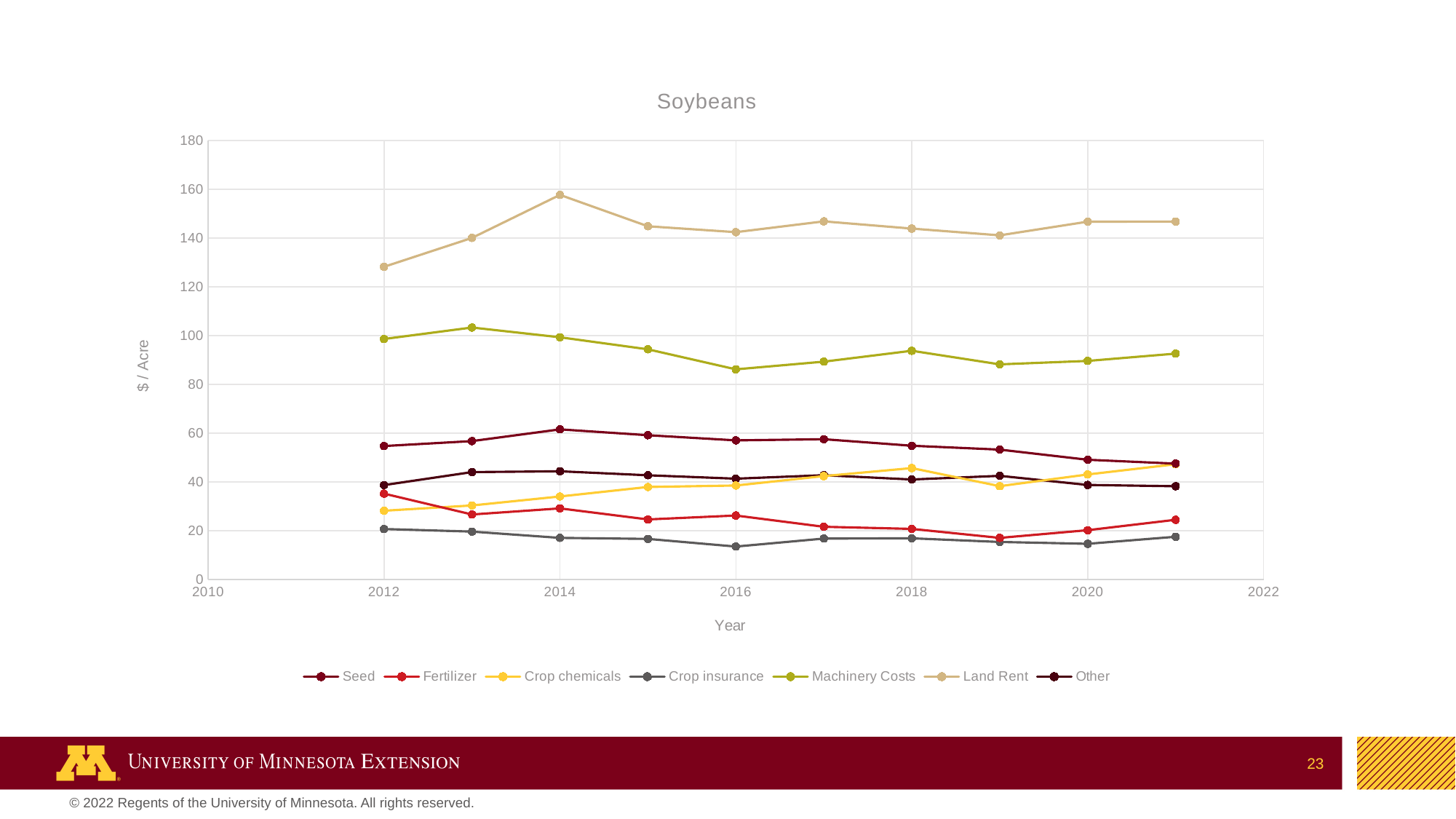
How many years of data are plotted for each series? 10 Is the value for Machinery Costs in 2016 greater or less than 100? less Which series has the lowest values across all years? Crop insurance Which is larger in 2012, Seed or Fertilizer? Seed What is the title of the chart? Soybeans Is the value for Land Rent in 2014 greater or less than 140? greater What kind of chart is shown on the slide? Line chart How many series does the legend list? 7 Is the value for Land Rent in 2012 greater or less than 140? less In which year does Land Rent reach its peak? 2014 Which series has the highest values across all years? Land Rent Does the Crop chemicals line rise or fall from 2012 to 2018? rise